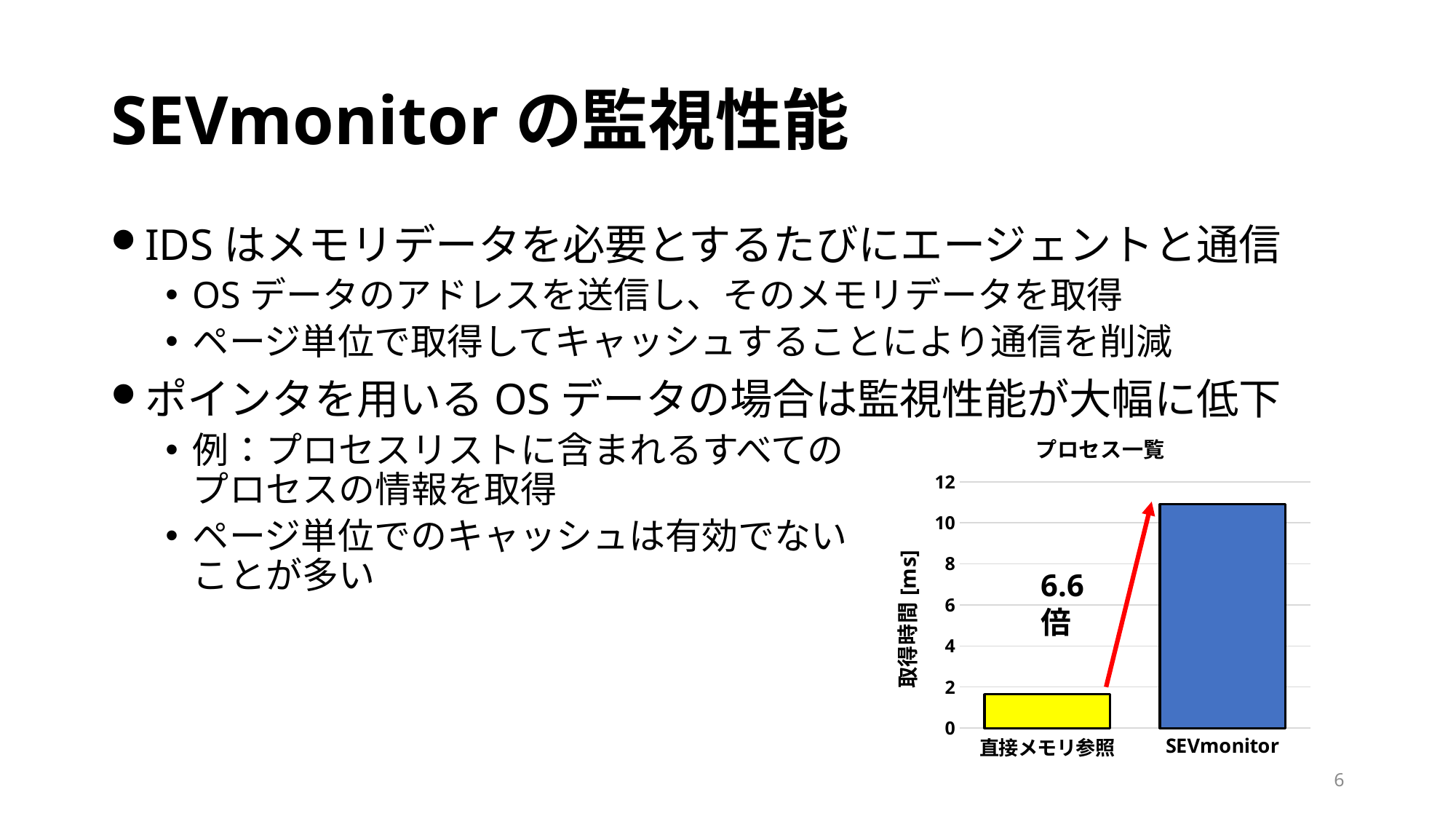
What is the label of the vertical axis of the chart? 取得時間 [ms] Is the value for 直接メモリ参照 greater or less than 2? less What kind of chart is shown on the slide? bar chart How many bars (categories) are plotted in the chart? 2 Which is larger, the value for 直接メモリ参照 or the value for SEVmonitor? SEVmonitor What is the title of the chart? プロセス一覧 What is the highest tick value shown on the vertical axis of the chart? 12 According to the annotation on the chart, how many times larger is the SEVmonitor value than the 直接メモリ参照 value? 6.6倍 Is the value for SEVmonitor greater or less than 10? greater Is the value for SEVmonitor greater or less than 12? less Which category has the lowest value in the chart? 直接メモリ参照 Which category has the highest value in the chart? SEVmonitor